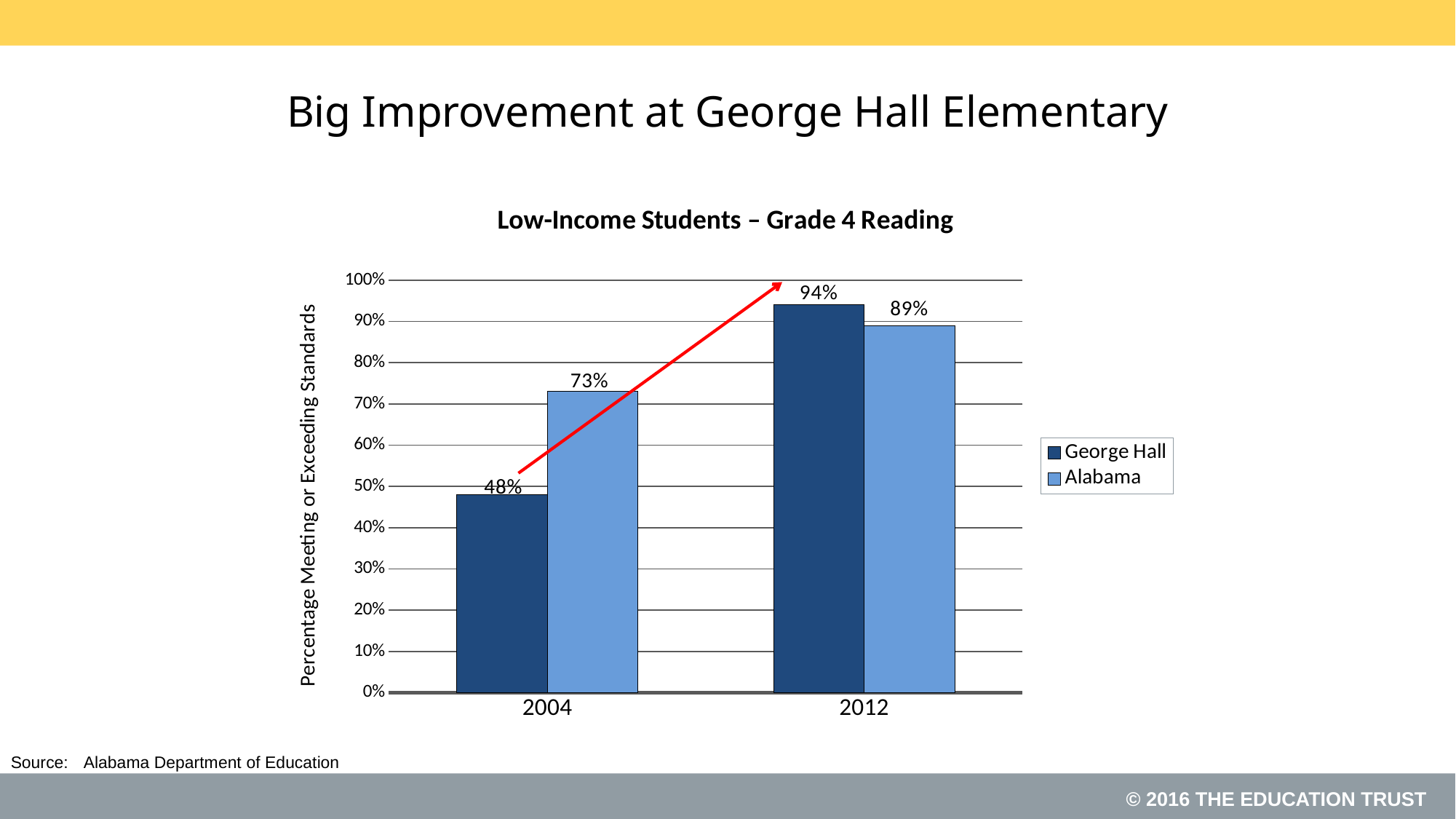
What was the value for George Hall in 2012? 94% By how many percentage points did George Hall's value increase from 2004 to 2012? 46 percentage points What was the value for Alabama in 2004? 73% In 2004, which was higher, George Hall or Alabama? Alabama Which bar on the chart has the highest value? George Hall in 2012 What was the value for George Hall in 2004? 48% What was the value for Alabama in 2012? 89% What kind of chart is shown on the slide? Bar chart Which bar on the chart has the lowest value? George Hall in 2004 How many series does the legend list? 2 What is the title of the chart? Low-Income Students – Grade 4 Reading What is the difference between George Hall and Alabama in 2012? 5 percentage points